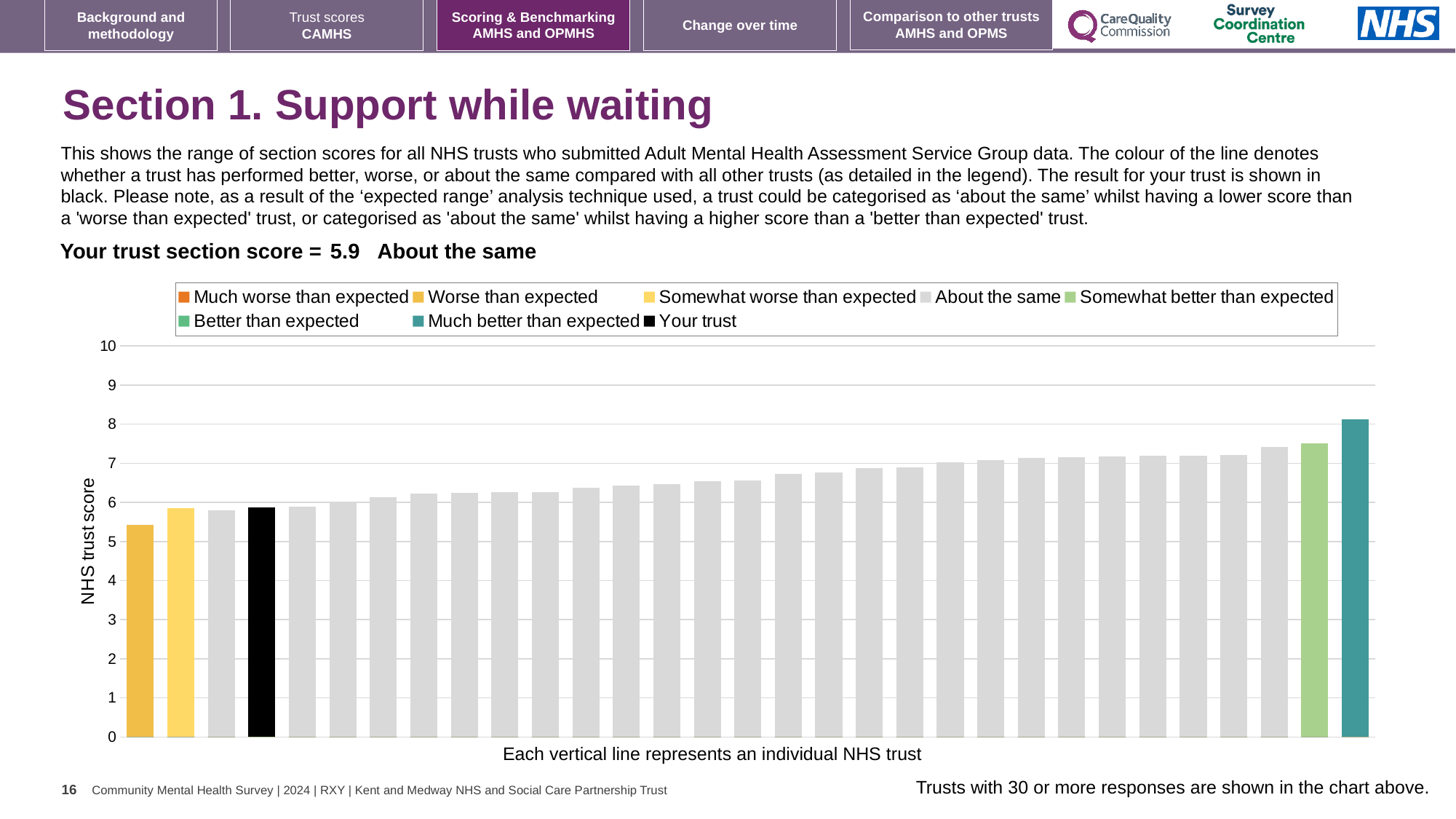
Which legend category does the tallest bar belong to? Much better than expected Do the bar values rise or fall from left to right across the chart? rise Which legend category does the shortest bar belong to? Worse than expected Is the value of the light green 'Somewhat better than expected' bar greater or less than 7? greater What is the section score for your trust, as printed on the slide? 5.9 Is the value of the rightmost (teal) bar greater or less than 7? greater Which is taller: the teal 'Much better than expected' bar or the light green 'Somewhat better than expected' bar? Much better than expected Which category does your trust's section score fall into, as printed on the slide? About the same What is the label on the vertical axis of the chart? NHS trust score What kind of chart is shown on the slide? bar chart Is the value of the leftmost bar greater or less than 6? less How many entries does the chart legend list? 8